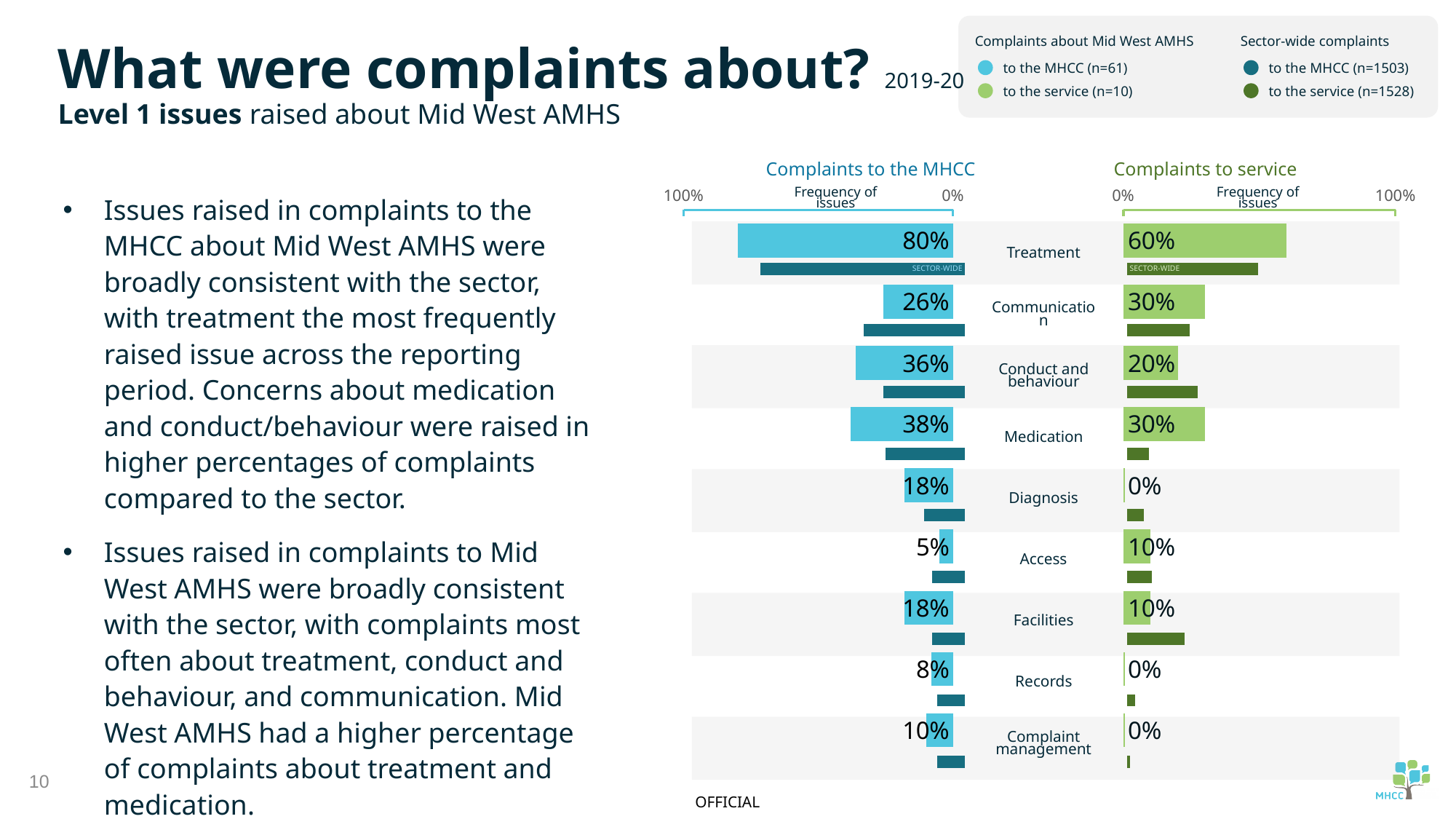
In the Complaints to service chart, what is the difference between the values for Treatment and Communication? 30% In the Complaints to the MHCC chart, what is the value for Treatment? 80% In the Complaints to the MHCC chart, which is larger, the value for Conduct and behaviour or the value for Communication? Conduct and behaviour In the Complaints to service chart, what is the value for Conduct and behaviour? 20% In the Complaints to service chart, what is the value for Treatment? 60% According to the legend, how many complaints to the MHCC about Mid West AMHS were there (n)? 61 In the Complaints to the MHCC chart, what is the difference between the values for Treatment and Medication? 42% In the Complaints to the MHCC chart, what is the value for Medication? 38% How many issue categories are listed in the chart? 9 In the Complaints to the MHCC chart, which issue has the highest value? Treatment In the Complaints to the MHCC chart, which issue has the lowest value? Access What kind of chart is shown on the slide? Bar chart